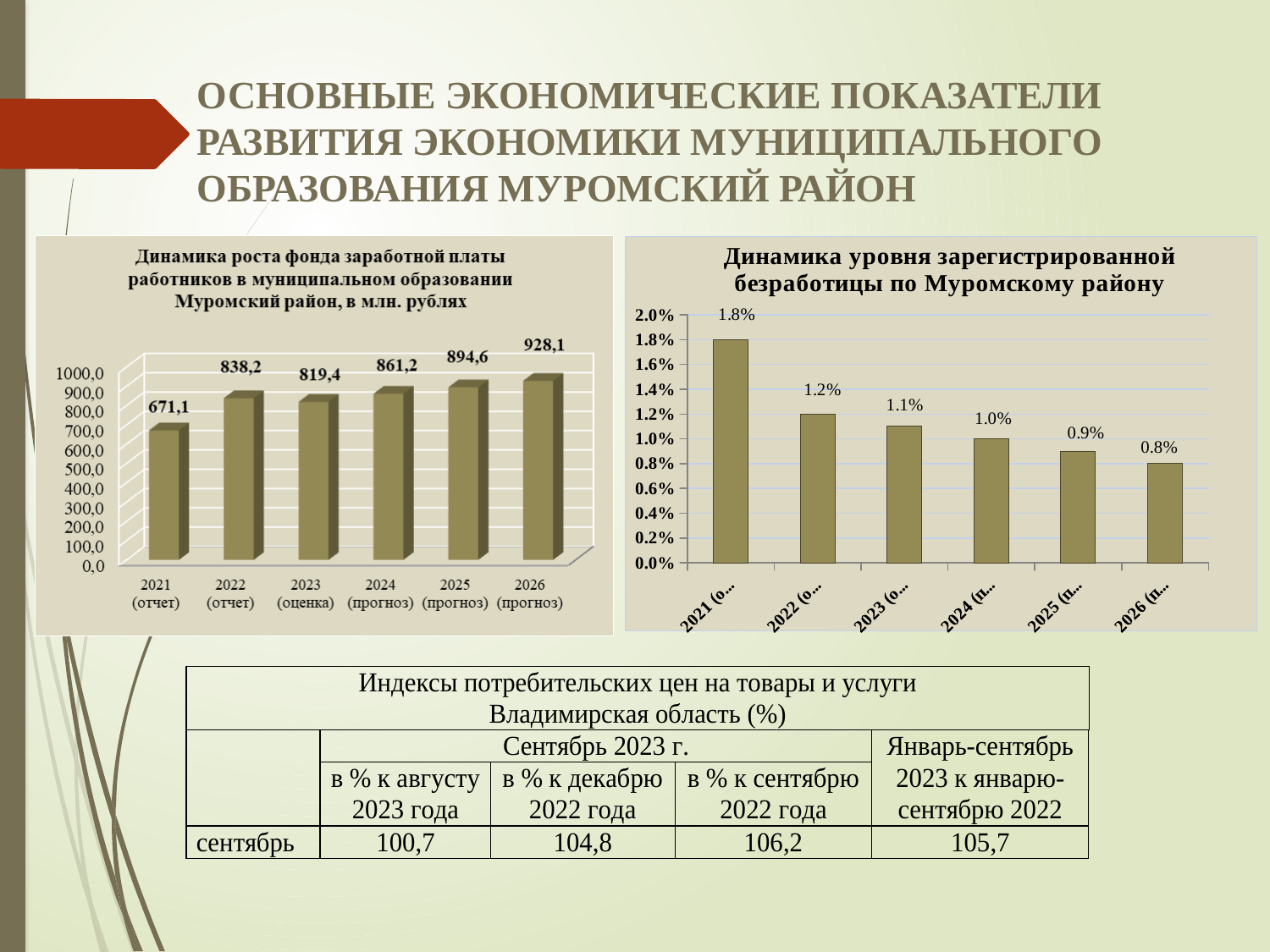
In the right chart (registered unemployment rate), do the values rise or fall from 2021 to 2026? fall What type of chart is the left chart (wage fund dynamics)? bar chart In the right chart (registered unemployment rate), which is larger, the value for 2023 or the value for 2025? 2023 In the right chart (registered unemployment rate), what is the value for 2024? 1.0% In the left chart (wage fund dynamics), how many years are shown on the x axis? 6 In the right chart (registered unemployment rate), what is the difference between the values for 2021 and 2022? 0.6% In the left chart (wage fund dynamics), what is the difference between the values for 2022 and 2023? 18,8 In the left chart (wage fund dynamics), which year has the highest value? 2026 In the left chart (wage fund dynamics), what is the value for 2026 (прогноз)? 928,1 In the left chart (wage fund dynamics), what is the value for 2021 (отчет)? 671,1 In the left chart (wage fund dynamics), which year has the lowest value? 2021 In the right chart (registered unemployment rate), what is the value for 2021? 1.8%